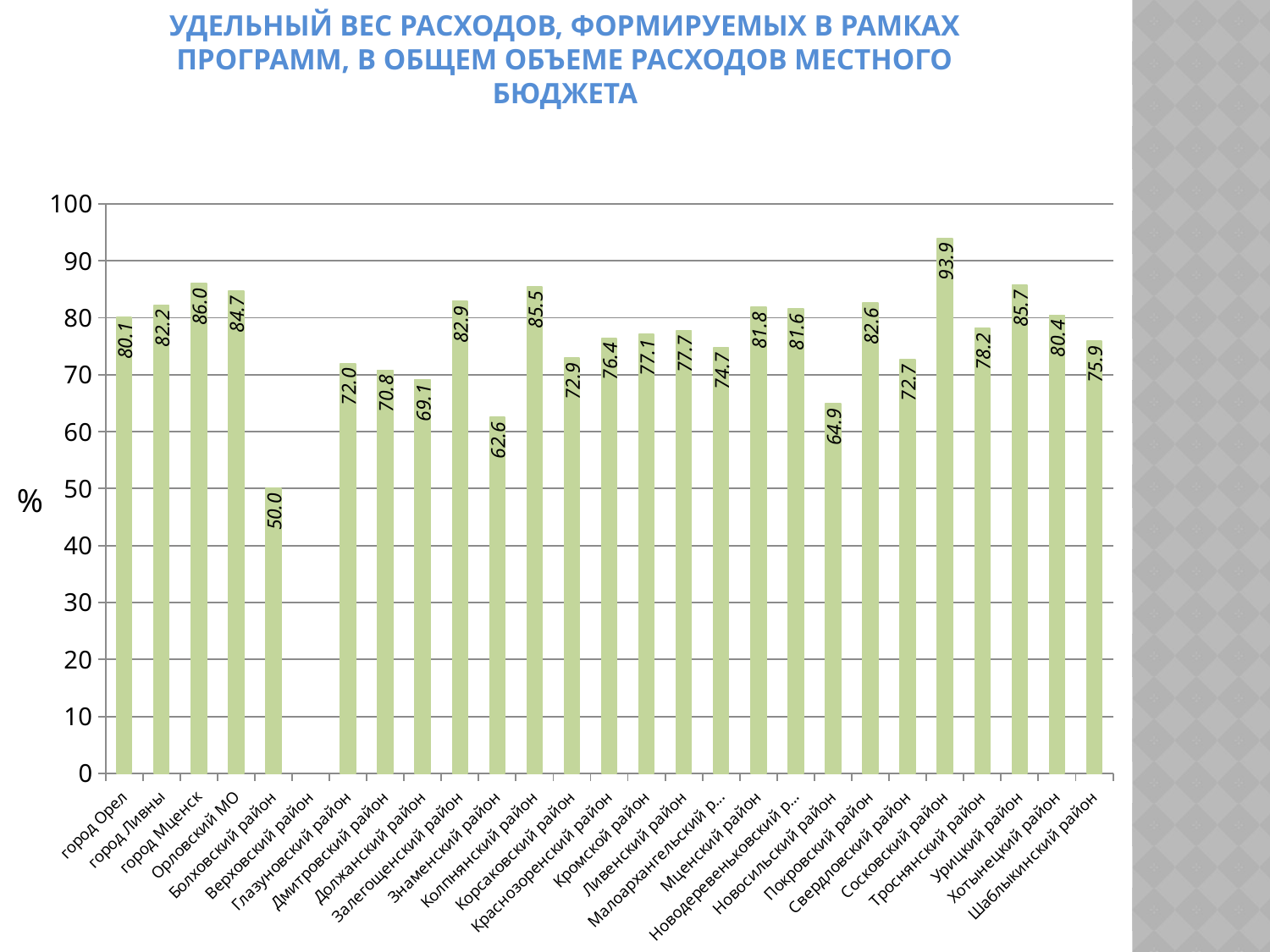
What kind of chart is shown on the slide? Bar chart What is the value for город Орел? 80.1 How many category labels are shown on the x axis? 27 What unit is shown on the vertical axis label? % What is the value for Сосковский район? 93.9 Which category has the highest value? Сосковский район What is the difference between the values for Сосковский район and Болховский район? 43.9 What is the value for Знаменский район? 62.6 Which is larger, the value for Залегощенский район or Знаменский район? Залегощенский район What is the difference between the values for город Мценск and город Орел? 5.9 What is the value for Новосильский район? 64.9 Which category with a plotted bar has the lowest value? Болховский район